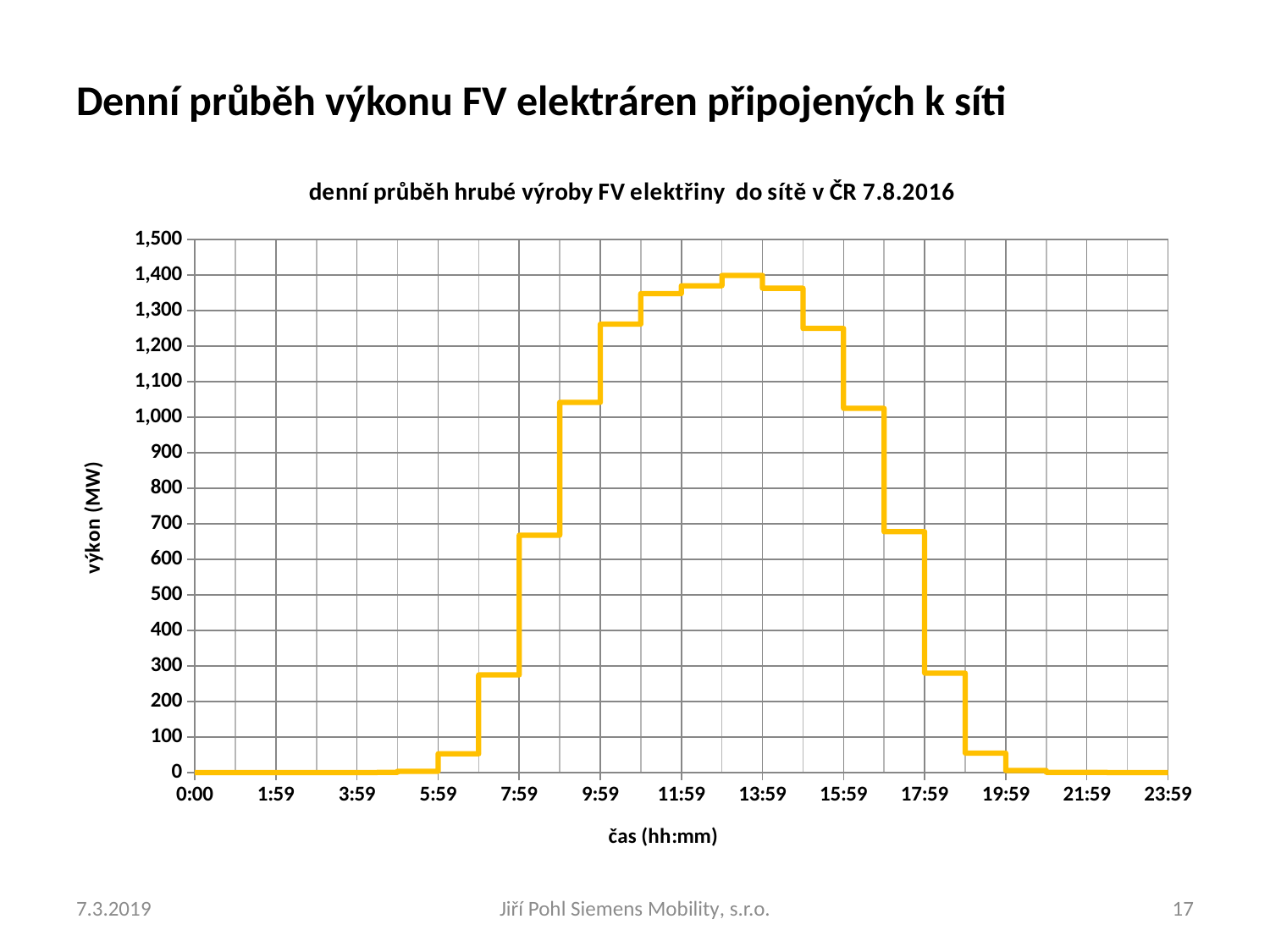
What is the title of the chart? denní průběh hrubé výroby FV elektřiny do sítě v ČR 7.8.2016 Is the value of the step immediately after 7:59 greater or less than 600? greater What is the label of the vertical axis? výkon (MW) Is the value of the step immediately after 9:59 greater or less than 1,200? greater What kind of chart is shown on the slide? line chart Is the value of the step immediately after 11:59 greater or less than 1,300? greater Which is larger: the value of the step immediately after 7:59 or the step immediately after 15:59? the step after 15:59 Does the line rise or fall between 13:59 and 19:59? fall Does the line rise or fall between 5:59 and 13:59? rise